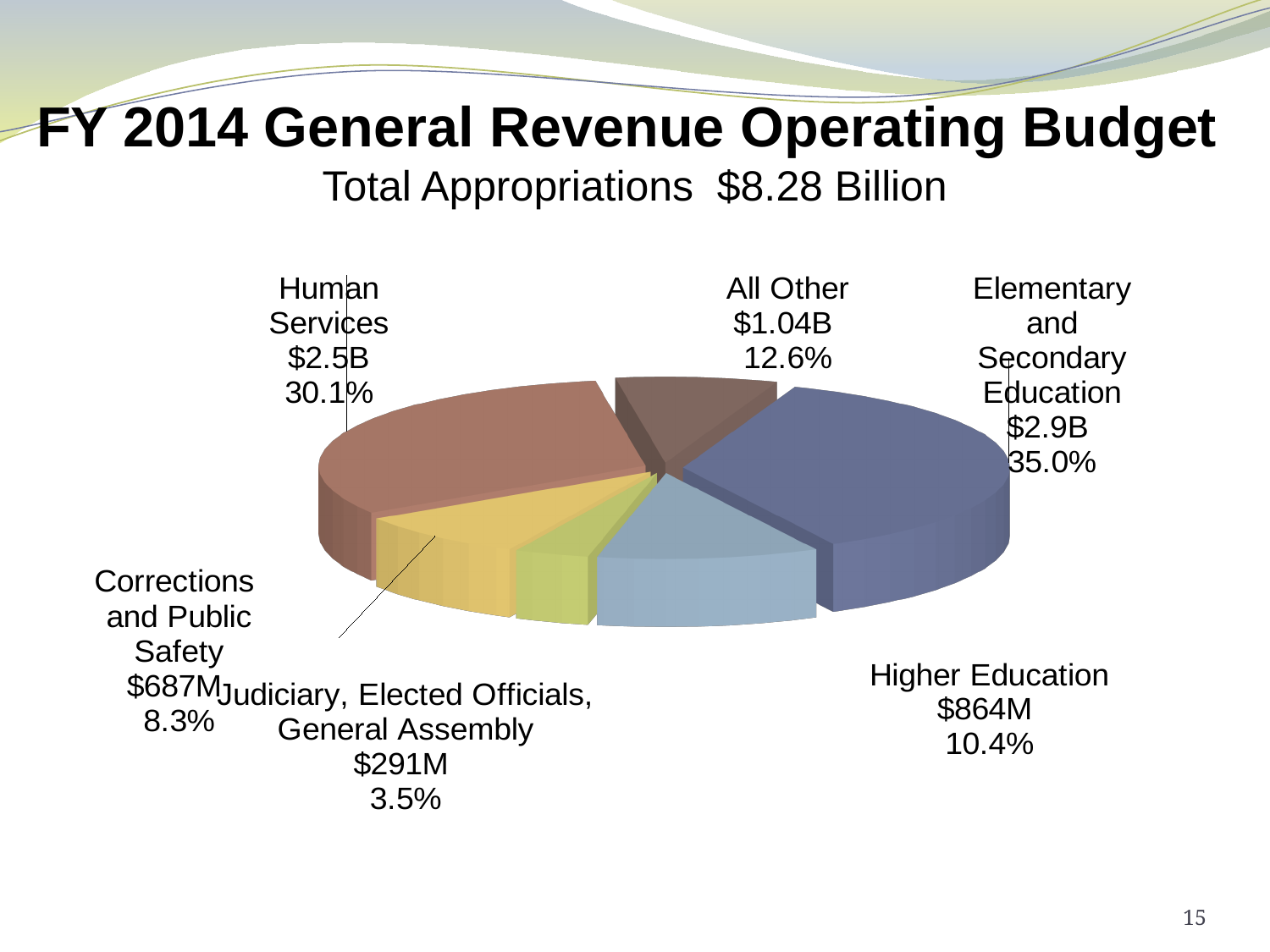
Which category has the smallest share of the budget? Judiciary, Elected Officials, General Assembly What total appropriations amount is stated in the chart subtitle? $8.28 Billion What share of the budget goes to Elementary and Secondary Education? 35.0% What is the difference in percentage points between Elementary and Secondary Education and Human Services? 4.9 What is the dollar amount for All Other? $1.04B What is the dollar amount for Corrections and Public Safety? $687M Which category has the largest share of the budget? Elementary and Secondary Education Which is larger, the share for All Other or the share for Higher Education? All Other What kind of chart is shown on the slide? Pie chart How many slices does the pie chart have? 6 What share of the budget is Higher Education? 10.4% What is the dollar amount for Human Services? $2.5B